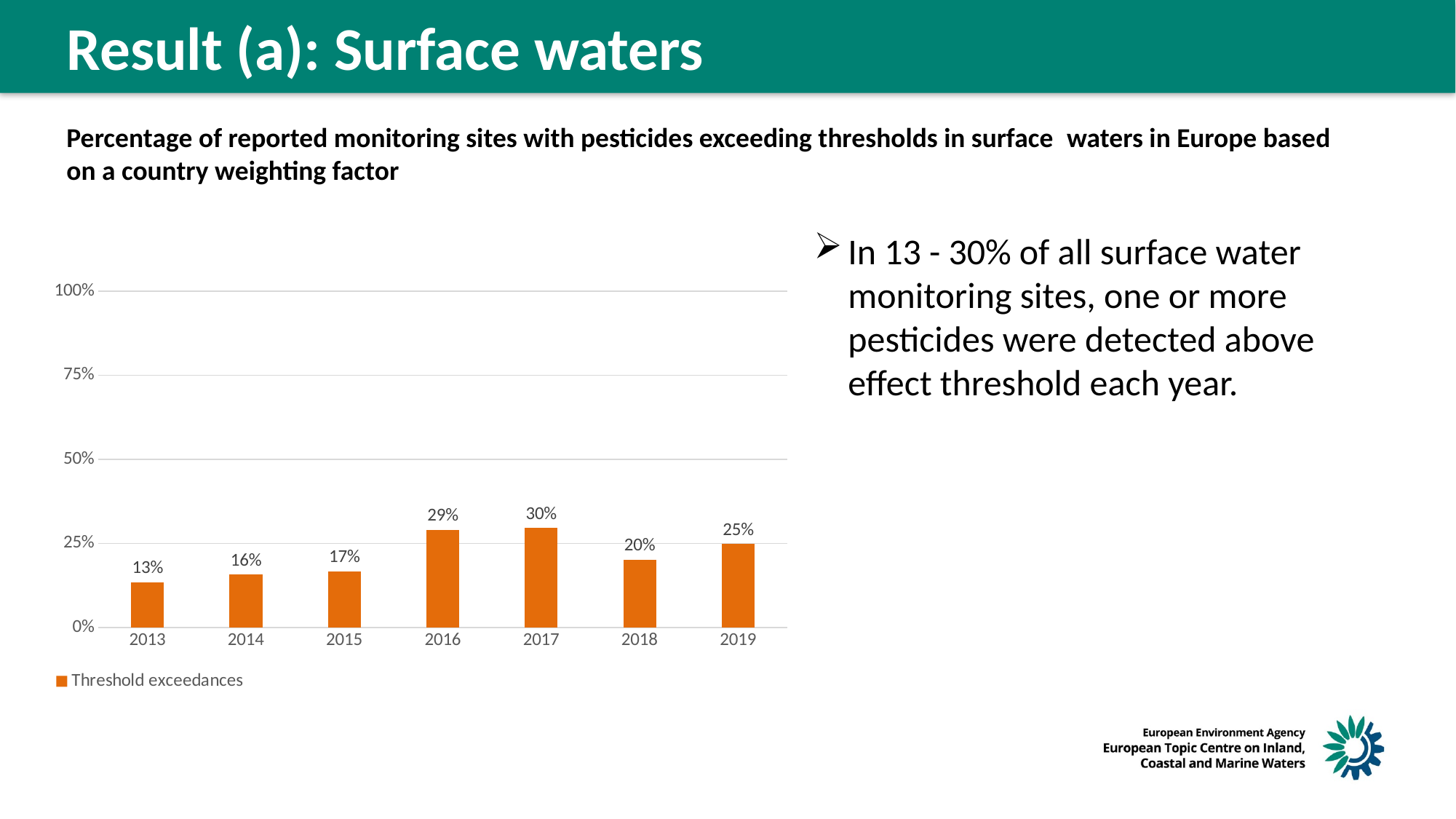
Which is larger, the value for 2016 or the value for 2019? 2016 What is the difference between the values for 2016 and 2013? 16% What kind of chart is shown on the slide? bar chart What is the difference between the values for 2017 and 2018? 10% Which year has the highest value? 2017 Which year has the lowest value? 2013 How many years are shown on the x axis? 7 What is the value for 2019? 25% What series name does the legend list? Threshold exceedances What is the value for 2013? 13% What is the value for 2017? 30% Is the value for 2018 greater or less than 25%? less